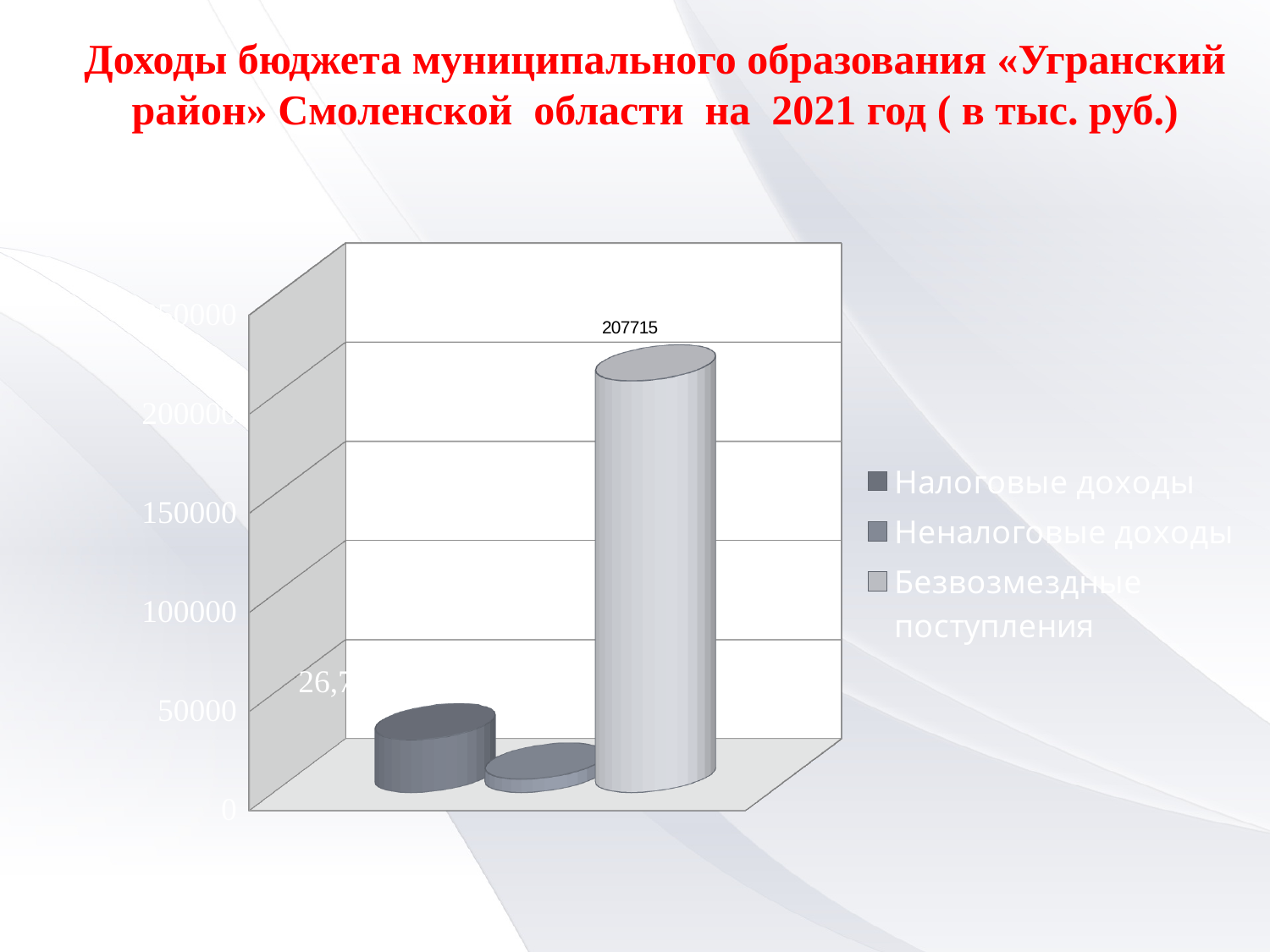
What kind of chart is shown on the slide? bar chart Which series has the lowest value? Неналоговые доходы Is the value for Неналоговые доходы greater or less than 50000? less What is the value for Безвозмездные поступления? 207715 Is the value for Налоговые доходы greater or less than 100000? less How many series does the legend list? 3 Which year does the chart title refer to? 2021 What unit of measurement is stated in the chart title? тыс. руб. Which series has the highest value? Безвозмездные поступления Is the value for Безвозмездные поступления greater or less than 200000? greater Which is larger, Налоговые доходы or Неналоговые доходы? Налоговые доходы How many bars are plotted on the chart? 3